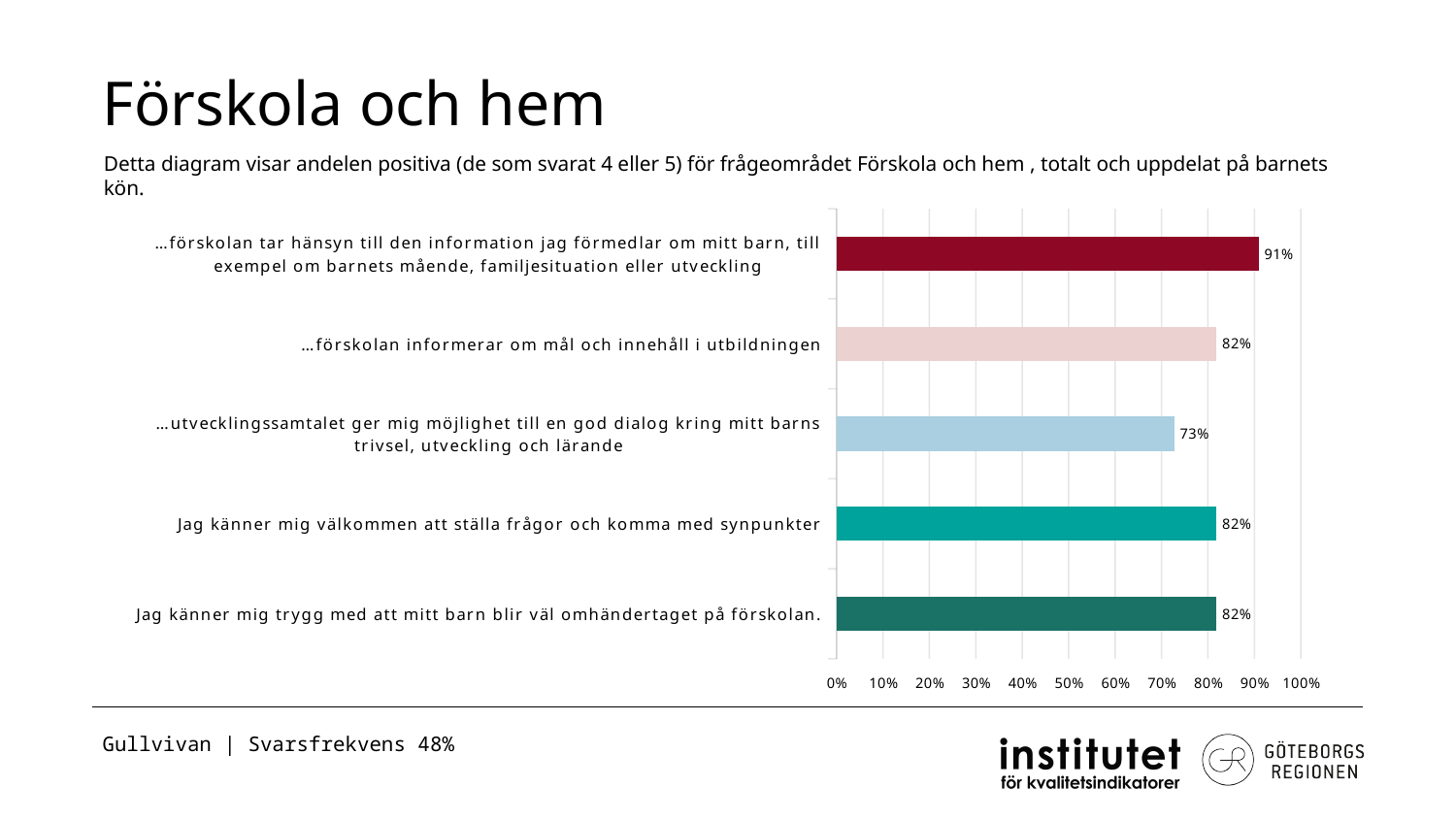
What is the difference between the highest value (91%) and the lowest value (73%)? 18 percentage points How many categories share the value 82%? 3 Which category has the highest value? …förskolan tar hänsyn till den information jag förmedlar om mitt barn, till exempel om barnets mående, familjesituation eller utveckling Which is larger: the value for "…förskolan informerar om mål och innehåll i utbildningen" or the value for "…utvecklingssamtalet ger mig möjlighet till en god dialog kring mitt barns trivsel, utveckling och lärande"? …förskolan informerar om mål och innehåll i utbildningen Which category has the lowest value? …utvecklingssamtalet ger mig möjlighet till en god dialog kring mitt barns trivsel, utveckling och lärande Is the value for "…utvecklingssamtalet ger mig möjlighet till en god dialog kring mitt barns trivsel, utveckling och lärande" greater or less than 80%? less What is the value for "…förskolan tar hänsyn till den information jag förmedlar om mitt barn, till exempel om barnets mående, familjesituation eller utveckling"? 91% How many categories (bars) are shown in the chart? 5 What is the value for "…förskolan informerar om mål och innehåll i utbildningen"? 82% What is the value for "Jag känner mig trygg med att mitt barn blir väl omhändertaget på förskolan."? 82% What is the value for "…utvecklingssamtalet ger mig möjlighet till en god dialog kring mitt barns trivsel, utveckling och lärande"? 73% What kind of chart is shown on the slide? Bar chart